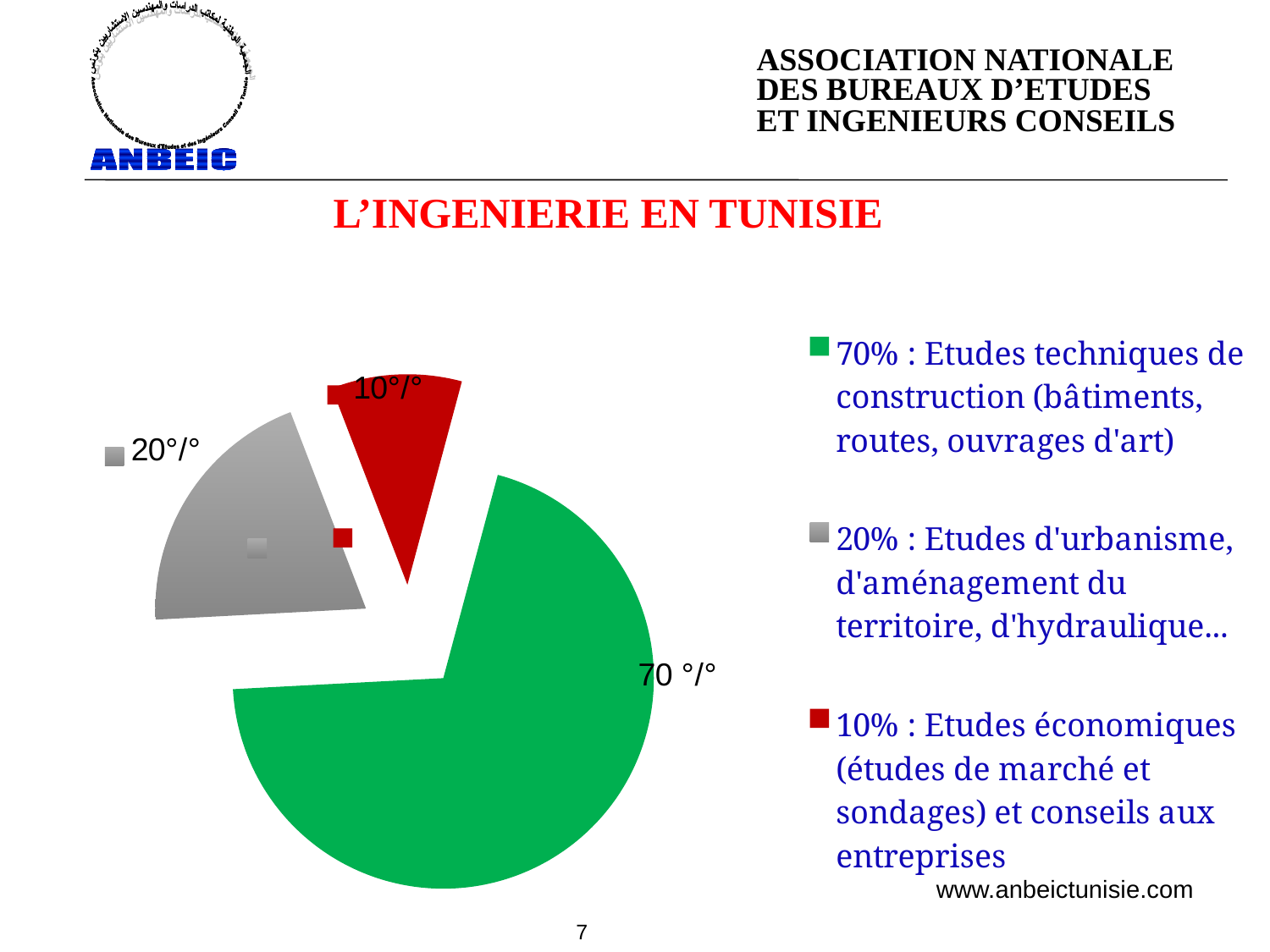
What colour is the slice for Etudes techniques de construction? green What colour is the slice for Etudes économiques et conseils aux entreprises? red Which is larger: the slice for Etudes d'urbanisme or the slice for Etudes économiques? Etudes d'urbanisme Which category has the smallest slice of the pie? Etudes économiques et conseils aux entreprises What kind of chart is shown on the slide? pie chart What share of the pie is Etudes techniques de construction? 70% What is the difference in percentage points between the Etudes d'urbanisme slice and the Etudes économiques slice? 10 How many slices does the pie chart have? 3 Which category has the largest slice of the pie? Etudes techniques de construction What is the difference in percentage points between the Etudes techniques de construction slice and the Etudes d'urbanisme slice? 50 What share of the pie is Etudes économiques et conseils aux entreprises? 10% What share of the pie is Etudes d'urbanisme, d'aménagement du territoire, d'hydraulique? 20%